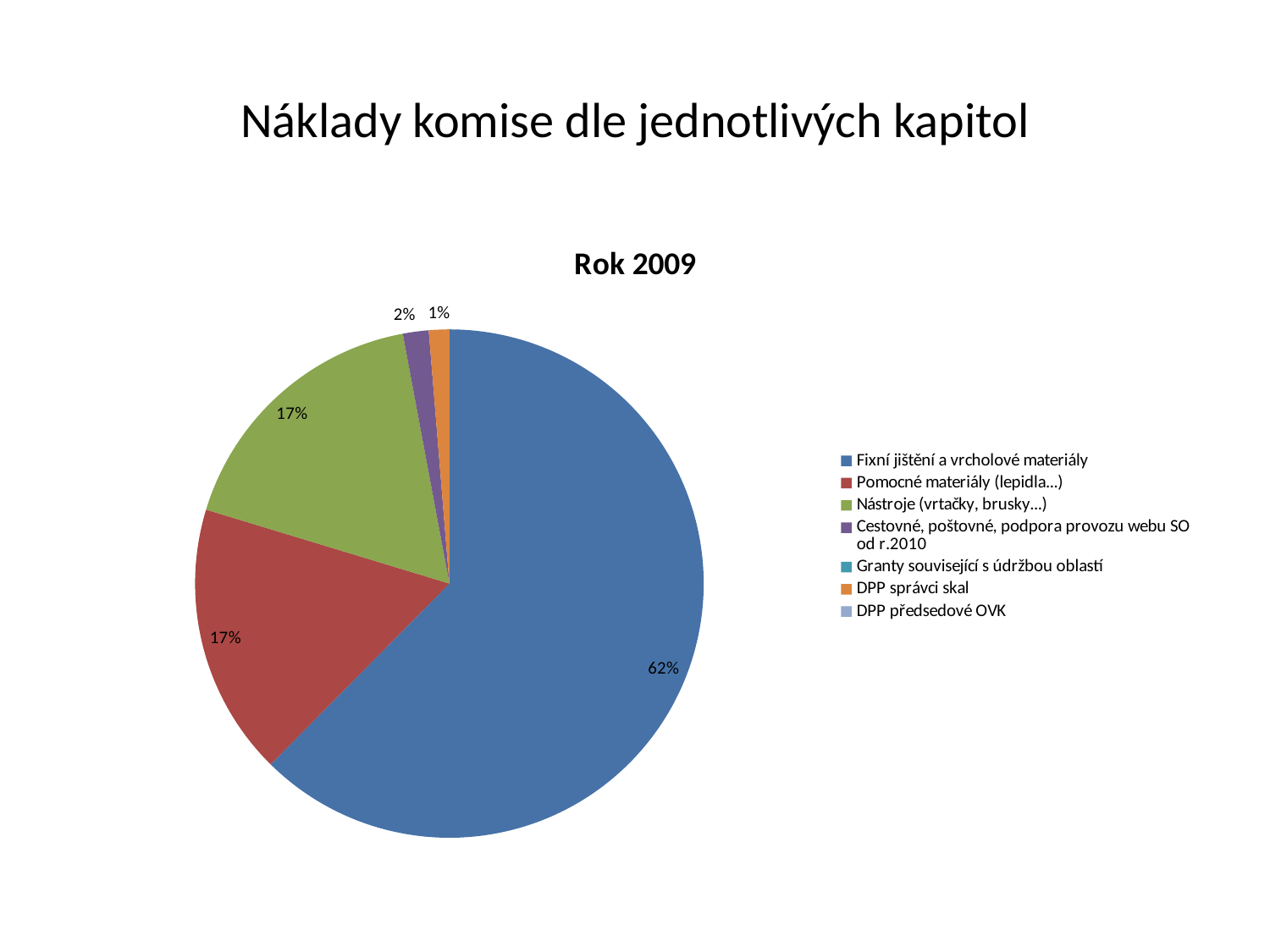
What percentage is shown for Nástroje (vrtačky, brusky…)? 17% What kind of chart is shown on the slide? pie chart What share of the pie does Fixní jištění a vrcholové materiály take? 62% What colour is the slice for Fixní jištění a vrcholové materiály? blue Which is larger, the slice for Fixní jištění a vrcholové materiály or the slice for Pomocné materiály (lepidla…)? Fixní jištění a vrcholové materiály What percentage is shown for Pomocné materiály (lepidla…)? 17% What is the title of the chart? Rok 2009 How many entries does the chart's legend list? 7 Which category has the largest slice of the pie? Fixní jištění a vrcholové materiály What percentage is shown for DPP správci skal? 1% What percentage is shown for Cestovné, poštovné, podpora provozu webu SO od r.2010? 2% What is the difference in percentage points between Fixní jištění a vrcholové materiály and Nástroje (vrtačky, brusky…)? 45